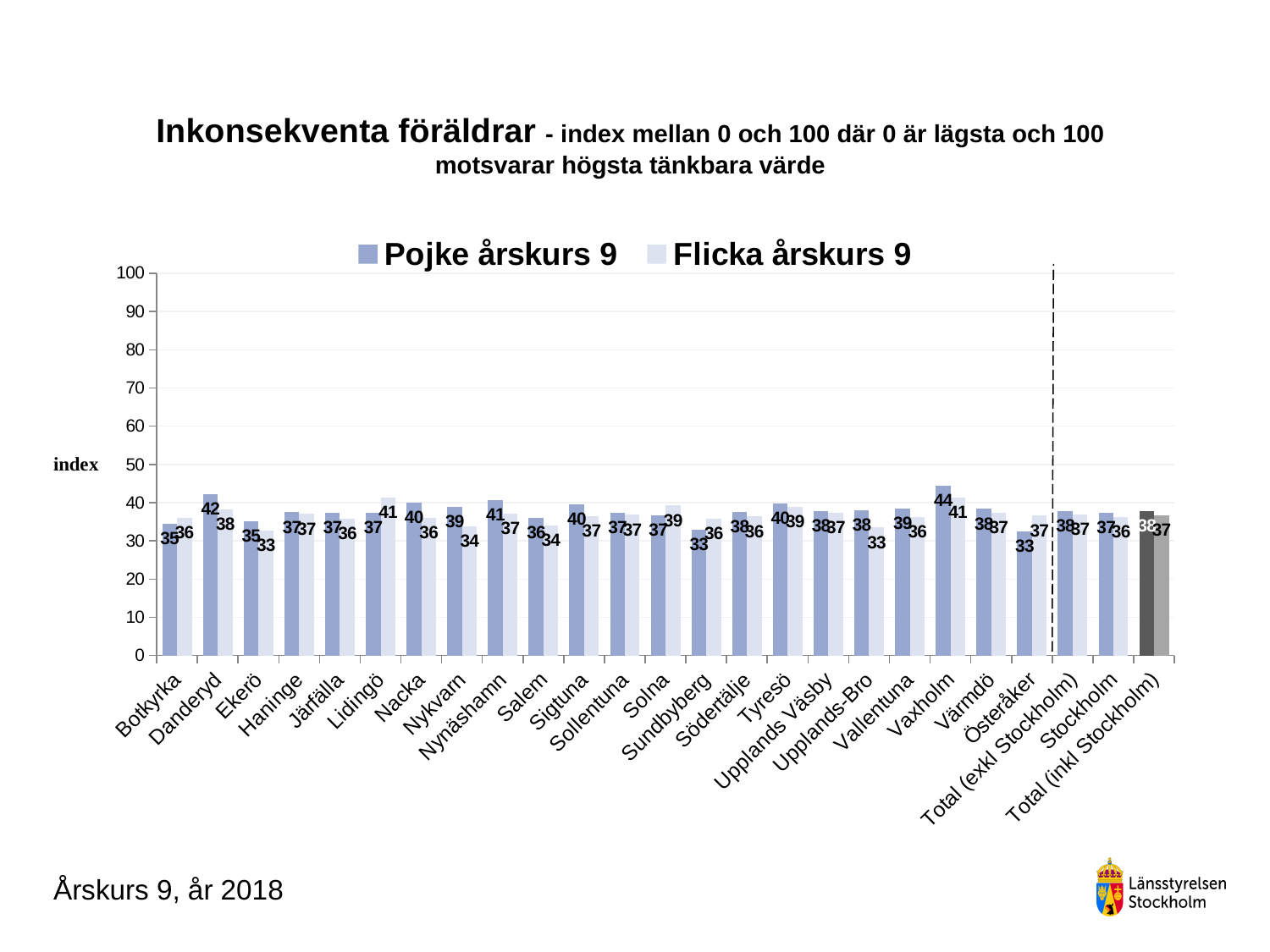
What are the two series named in the legend? Pojke årskurs 9 and Flicka årskurs 9 What is the value for Pojke årskurs 9 in Danderyd? 42 What is the value for Flicka årskurs 9 for Total (inkl Stockholm)? 37 Which category has the highest value for Pojke årskurs 9? Vaxholm Is the value for Pojke årskurs 9 in Danderyd greater or less than 40? greater What is the value for Flicka årskurs 9 in Lidingö? 41 What kind of chart is shown on the slide? bar chart How many series does the legend list? 2 In Nacka, which series has the larger value, Pojke årskurs 9 or Flicka årskurs 9? Pojke årskurs 9 What is the difference between the Pojke årskurs 9 and Flicka årskurs 9 values in Danderyd? 4 What is the difference between the Pojke årskurs 9 and Flicka årskurs 9 values in Vaxholm? 3 How many categories are shown on the x axis? 25